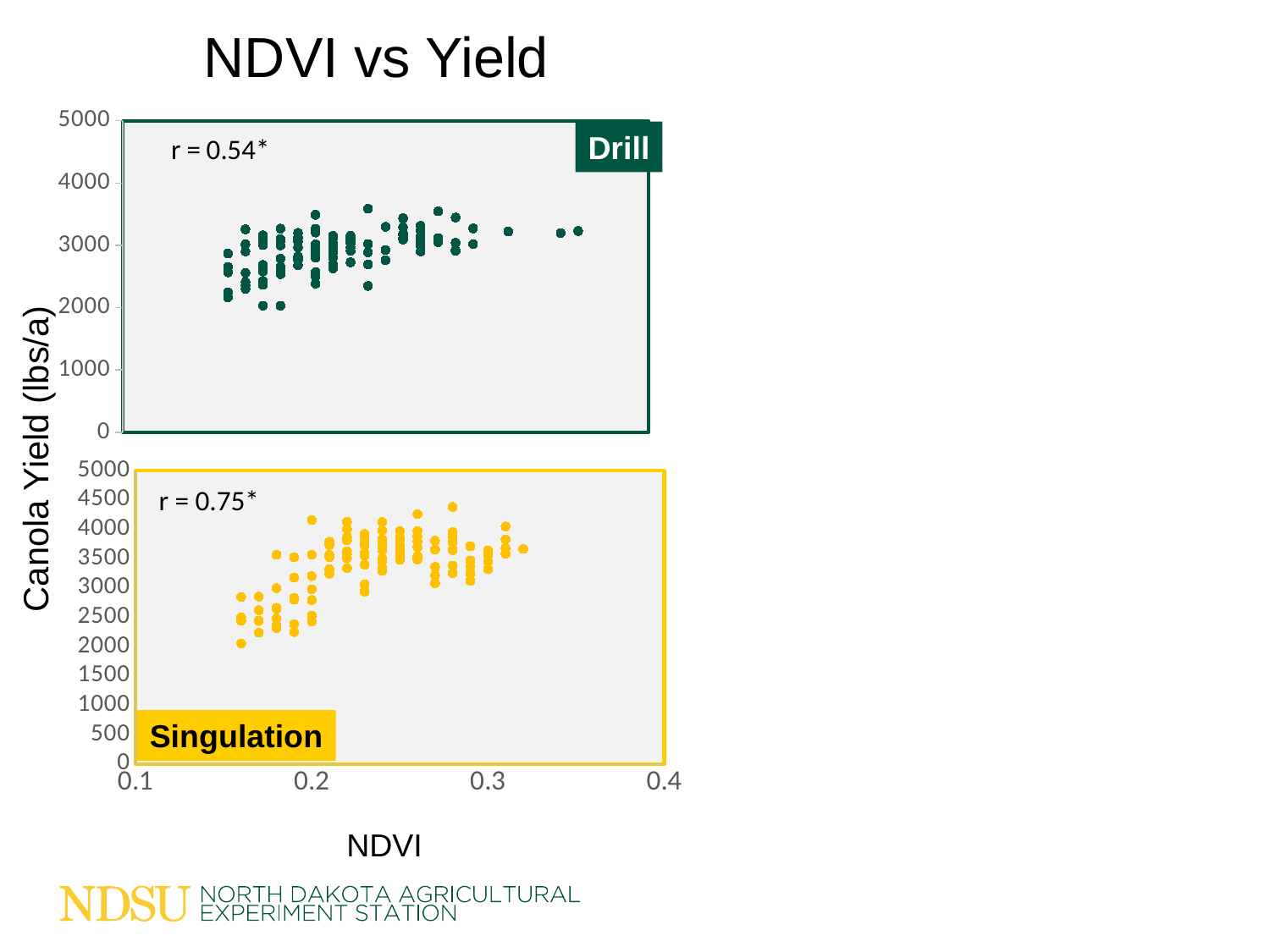
What is the maximum value shown on the y axis of the Singulation chart? 5000 In the Drill chart, is the highest plotted yield greater or less than 4000 lbs/a? less Which chart shows the higher correlation coefficient, Drill or Singulation? Singulation What is the label on the shared x axis of the two charts? NDVI What correlation coefficient is printed on the Drill chart? r = 0.54* What kind of chart is the top chart labelled Drill? scatter plot In the Singulation chart, does canola yield generally rise or fall as NDVI increases? rise What correlation coefficient is printed on the Singulation chart? r = 0.75* What is the title of the slide's chart figure? NDVI vs Yield In the Singulation chart, is the lowest plotted yield greater or less than 1500 lbs/a? greater In the Drill chart, is the largest NDVI value plotted greater or less than 0.3? greater In the Drill chart, does canola yield generally rise or fall as NDVI increases? rise